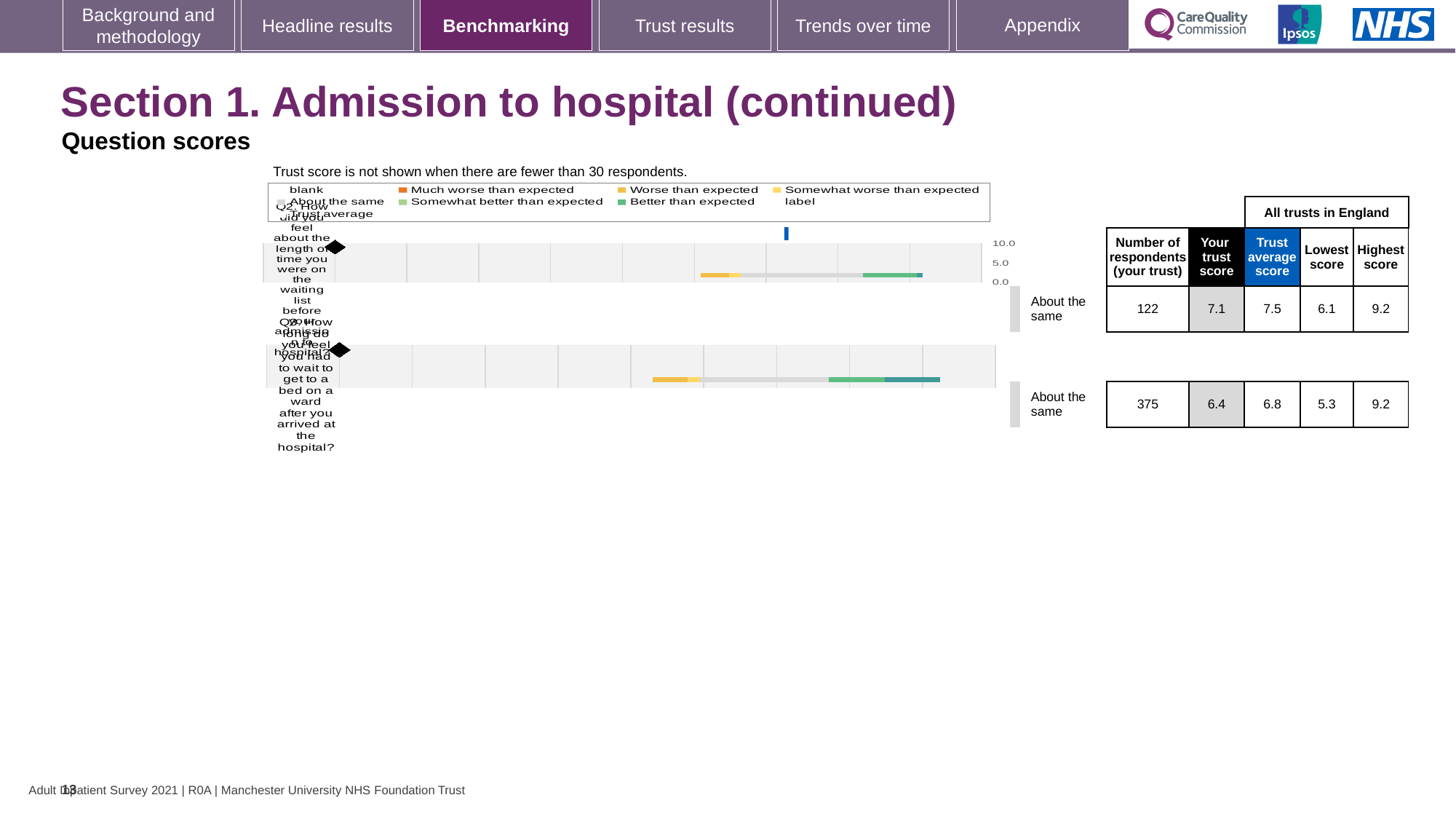
How many respondents from the trust answered Q3? 375 How many respondents from the trust answered Q2? 122 What is the trust average score across all trusts in England for Q2? 7.5 What is the highest score among all trusts in England for Q2? 9.2 What is the difference between the highest and lowest scores across all trusts in England for Q2? 3.1 What is the lowest score among all trusts in England for Q3? 5.3 How is this trust's score for Q3 rated relative to what is expected? About the same How many questions are plotted on the chart? 2 What is the difference between the trust average score and this trust's score for Q3? 0.4 What is the trust score for Q2 (how did you feel about the length of time you were on the waiting list before admission)? 7.1 Which question has the higher trust score, Q2 or Q3? Q2 What is the trust score for Q3 (how long did you feel you had to wait to get to a bed on a ward after you arrived at the hospital)? 6.4